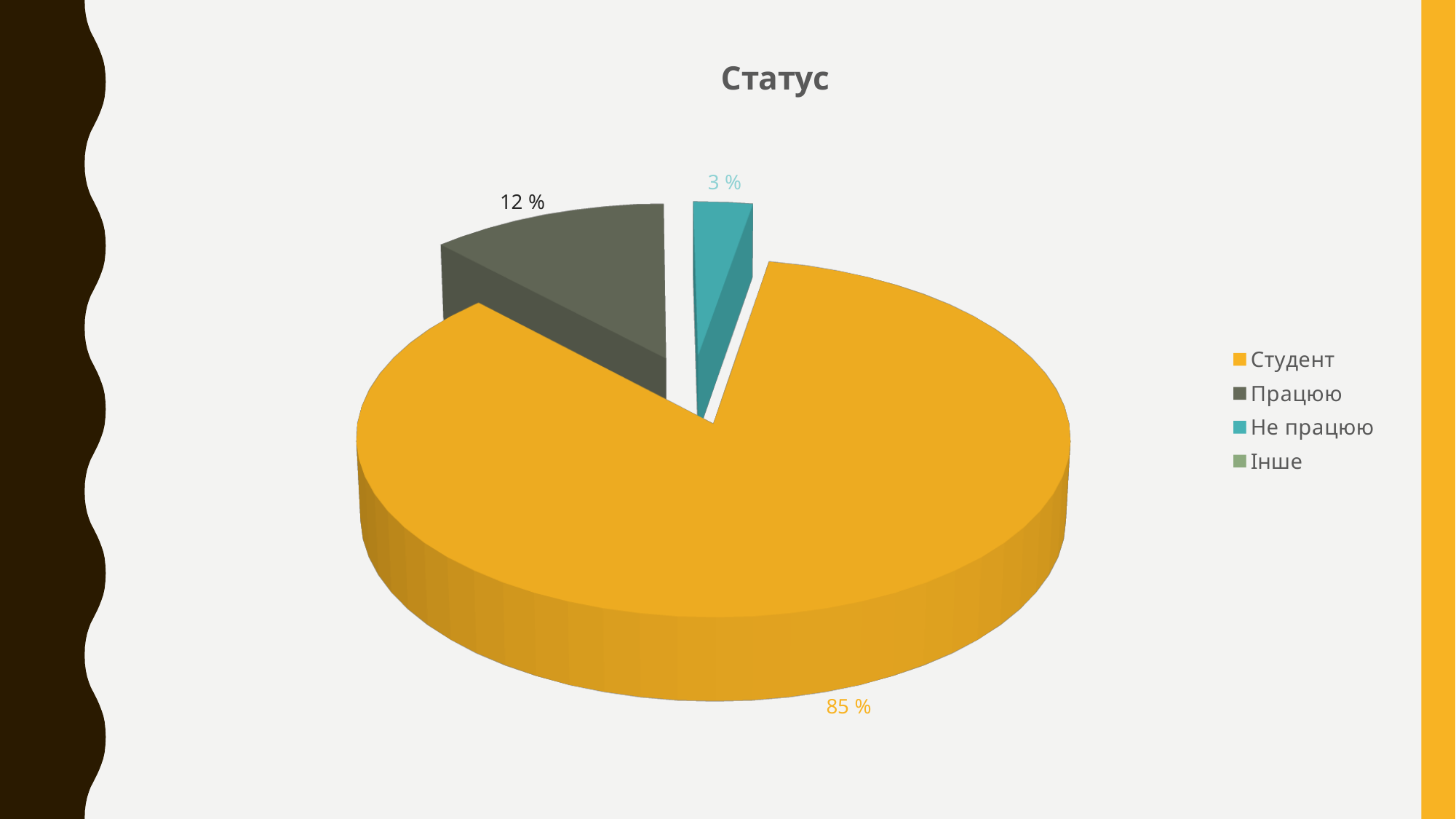
What kind of chart is shown on the slide? pie chart What share of the pie does Не працюю have? 3 % What is the title of the chart? Статус What colour is the slice for Студент? yellow/orange What share of the pie does Працюю have? 12 % What is the difference in percentage points between Працюю and Не працюю? 9 Which labelled slice is the smallest? Не працюю What share of the pie does Студент have? 85 % What is the difference in percentage points between Студент and Працюю? 73 Which category has the largest slice of the pie? Студент Which is larger, the slice for Працюю or the slice for Не працюю? Працюю How many entries does the legend list? 4